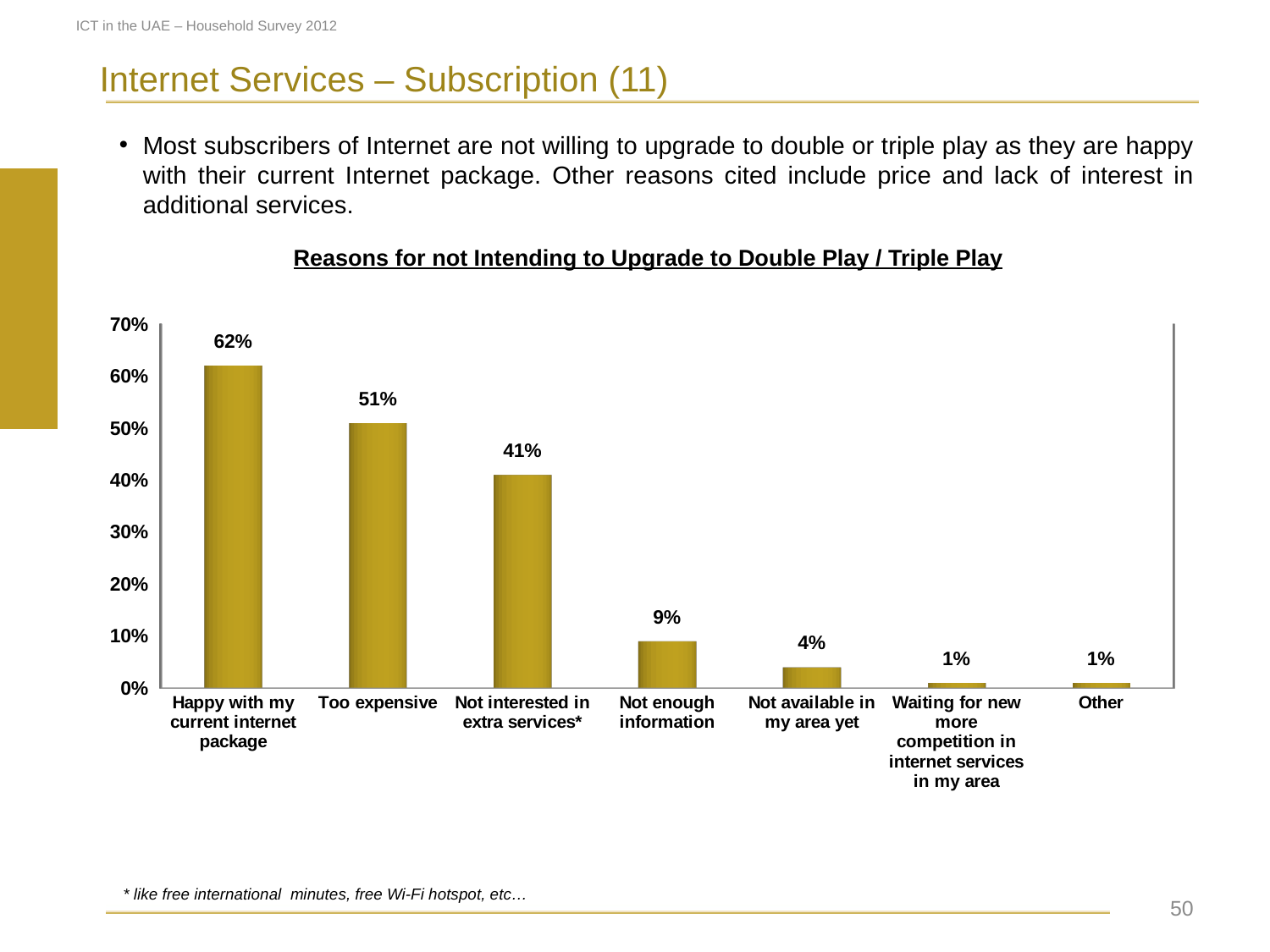
Which reason has the highest percentage in the chart? Happy with my current internet package What percentage is shown for 'Not enough information'? 9% What is the value shown for 'Too expensive'? 51% What is the title of the chart? Reasons for not Intending to Upgrade to Double Play / Triple Play What type of chart is used on this slide? Bar chart Do the values rise or fall moving from left to right across the categories? Fall What is the difference between 'Happy with my current internet package' and 'Too expensive'? 11% Which is larger: the value for 'Not enough information' or the value for 'Not available in my area yet'? Not enough information What is the value for 'Not available in my area yet'? 4% What percentage of respondents cited 'Happy with my current internet package' as a reason for not upgrading? 62% How many reason categories are shown in the chart? 7 What is the difference in percentage points between 'Too expensive' and 'Not interested in extra services*'? 10%